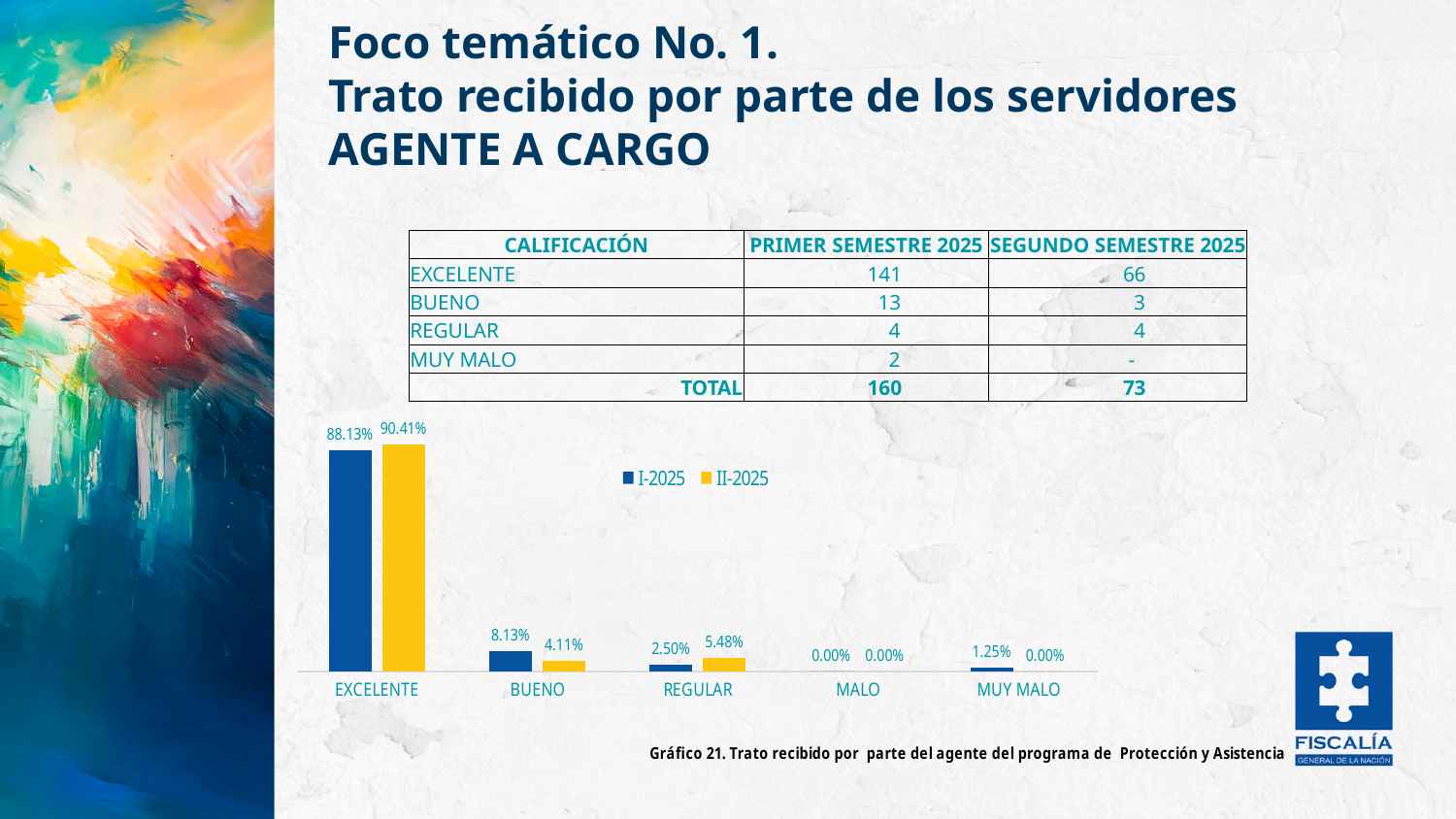
What is the difference between the II-2025 and I-2025 values for EXCELENTE? 2.28% What is the value for MUY MALO in the I-2025 series? 1.25% How many series does the chart legend list? 2 What kind of chart is shown on the slide? Bar chart Which category has the lowest value in the I-2025 series? MALO Which colour represents the II-2025 series in the chart? Yellow What is the value for EXCELENTE in the I-2025 series? 88.13% Which category has the highest value in the II-2025 series? EXCELENTE How many categories are shown on the x axis of the chart? 5 What is the value for BUENO in the II-2025 series? 4.11% Which is larger for BUENO: the I-2025 value or the II-2025 value? I-2025 What is the value for REGULAR in the II-2025 series? 5.48%